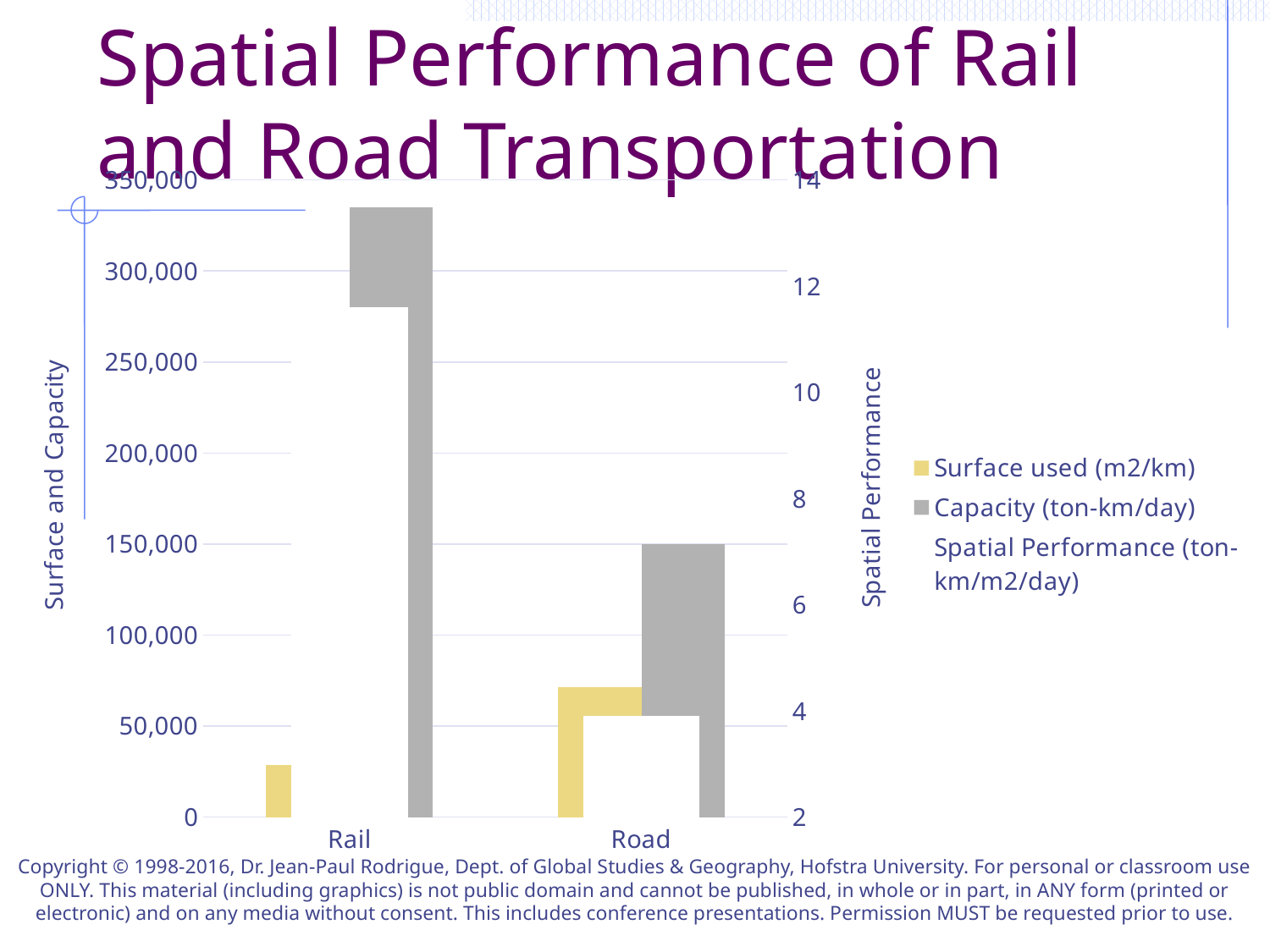
Is the Capacity (ton-km/day) value for Rail greater or less than 300,000? greater What is the label of the left vertical axis? Surface and Capacity Is the Surface used (m2/km) value for Rail greater or less than 50,000? less How many categories are shown on the x axis? 2 Is the Surface used (m2/km) value for Road greater or less than 100,000? less Which category has the higher Capacity (ton-km/day), Rail or Road? Rail What is the label of the right vertical axis? Spatial Performance Which category has the higher Surface used (m2/km), Rail or Road? Road What kind of chart is shown on the slide? bar chart How many series does the legend list? 3 Which series has the tallest bar on the chart? Capacity (ton-km/day)